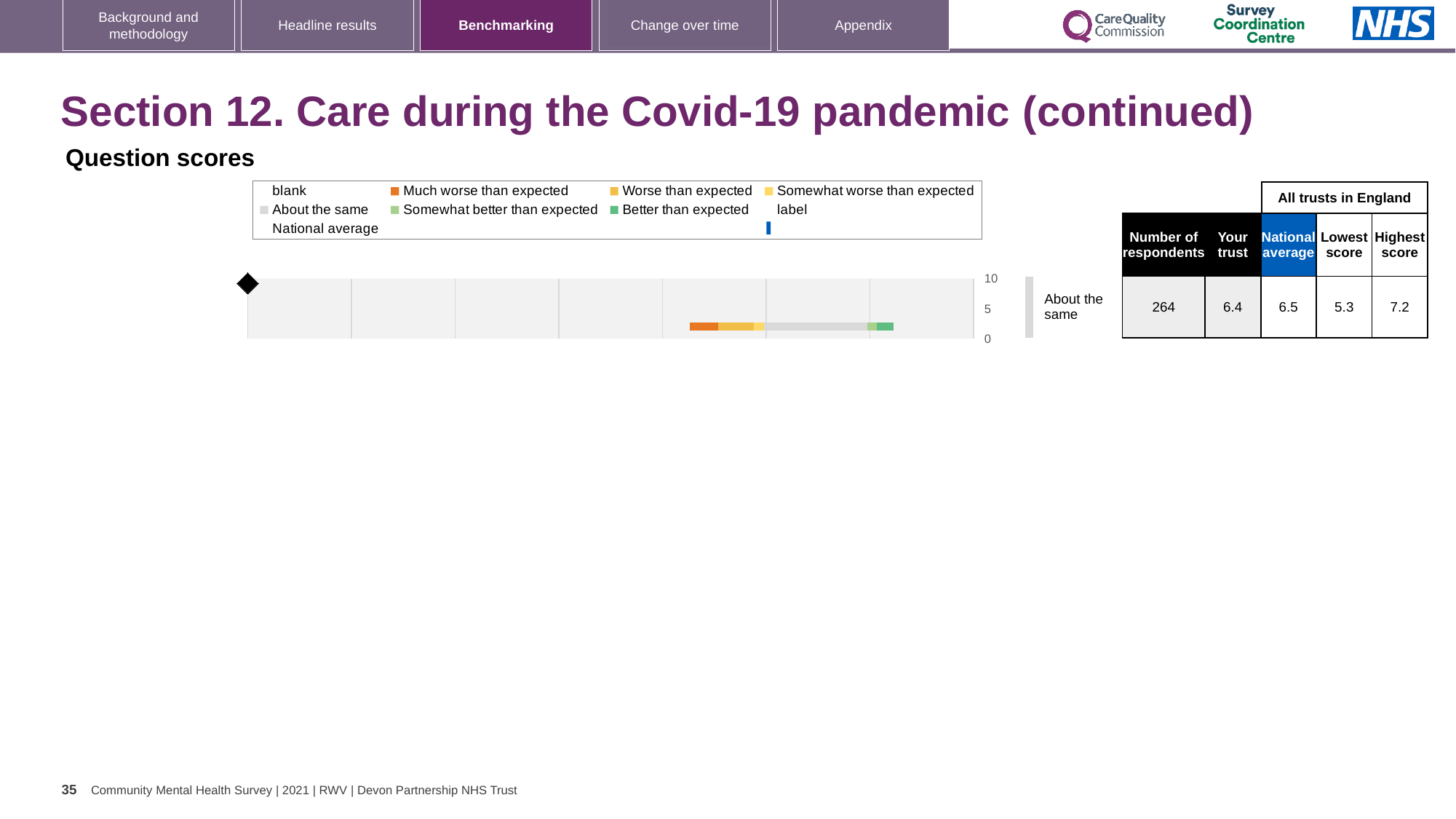
What is the difference between the national average and the 'Your trust' score? 0.1 What is the highest score among all trusts in England shown in the table? 7.2 What is the 'Your trust' score shown in the table next to the chart? 6.4 Which colour does the legend use for 'Much worse than expected'? Orange What kind of chart is shown on the slide? Bar chart What is the highest value shown on the chart's axis? 10 What is the lowest score among all trusts in England shown in the table? 5.3 What benchmark category label is shown to the right of the chart for this question? About the same Which is larger, the 'Your trust' score or the national average? National average What is the national average score shown in the table? 6.5 What is the difference between the highest score and the lowest score in the table? 1.9 How many respondents are listed for this question? 264